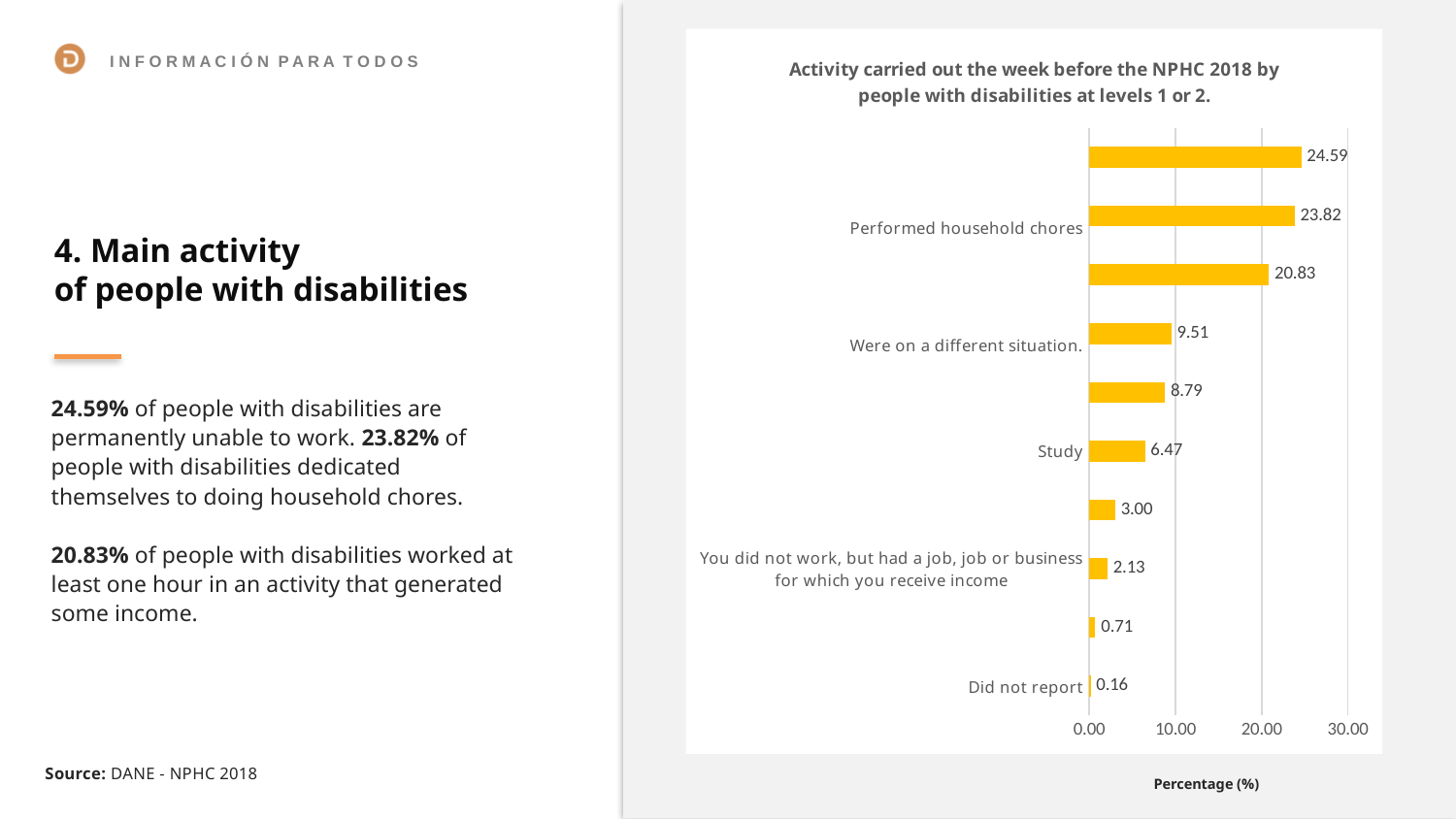
What is the difference between the values for Performed household chores and Study? 17.35 What is the value for Did not report? 0.16 How many bars are plotted on the chart? 10 Which is larger, the value for Were on a different situation or the value for Study? Were on a different situation What is the value for Were on a different situation? 9.51 What is the title of the chart? Activity carried out the week before the NPHC 2018 by people with disabilities at levels 1 or 2. What is the highest value shown on the chart? 24.59 What is the value for Study? 6.47 Which labelled category has the lowest value? Did not report What is the value for Performed household chores? 23.82 What kind of chart is shown on the slide? bar chart What is the value for 'You did not work, but had a job, job or business for which you receive income'? 2.13